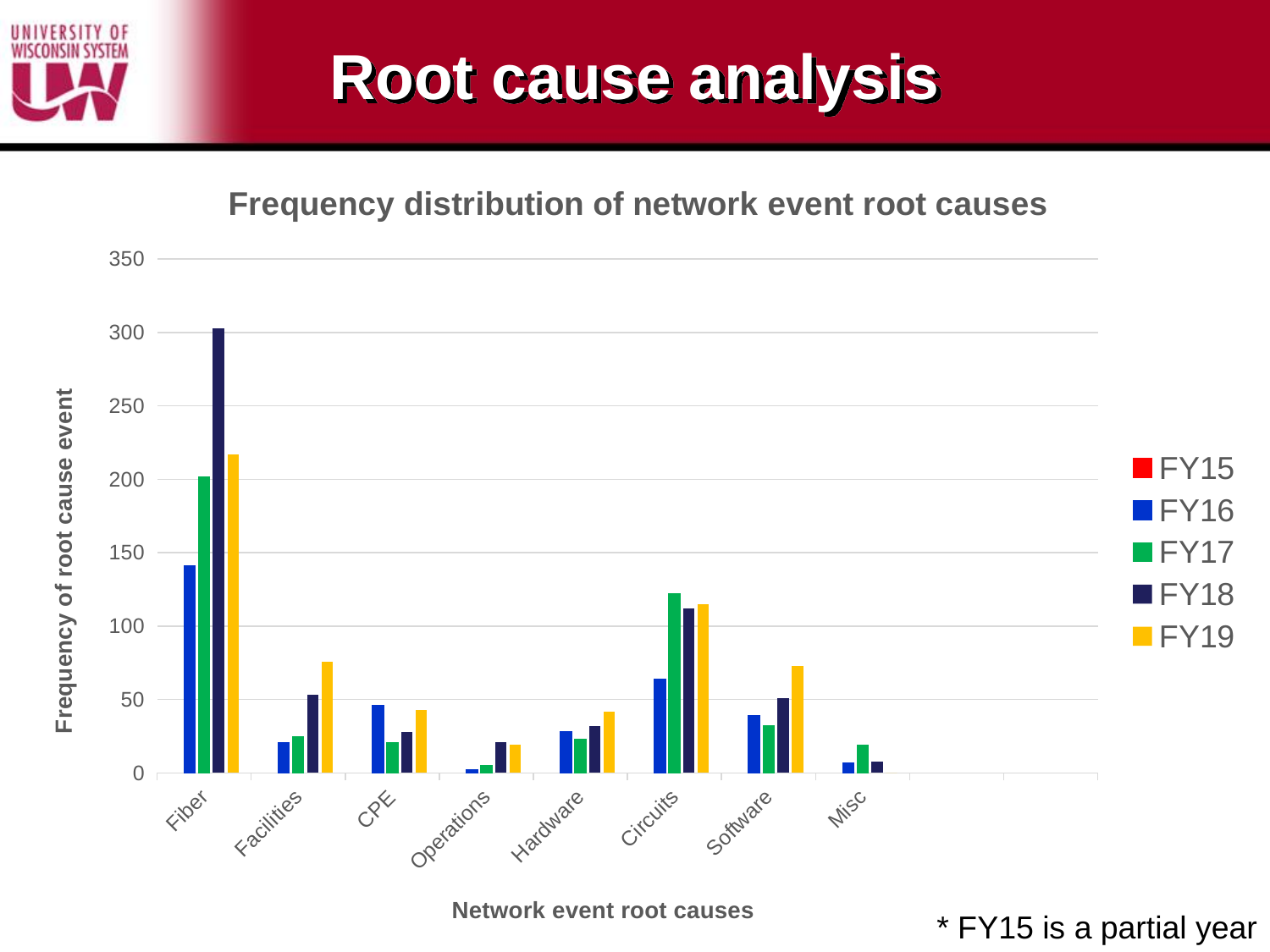
Is the FY16 value for Fiber greater or less than 150? less Which root cause category has the highest FY18 bar? Fiber Is the FY18 value for Fiber greater or less than 250? greater What is the title of the chart? Frequency distribution of network event root causes What kind of chart is shown on the slide? bar chart For Facilities, which fiscal year has the highest bar? FY19 Which root cause category has the lowest FY16 bar? Operations Is the FY17 value for Circuits greater or less than 100? greater How many series does the legend list? 5 How many labelled root cause categories are shown on the x axis? 8 For Software, which fiscal year has the highest bar? FY19 Which is larger for Hardware, the FY19 value or the FY16 value? FY19